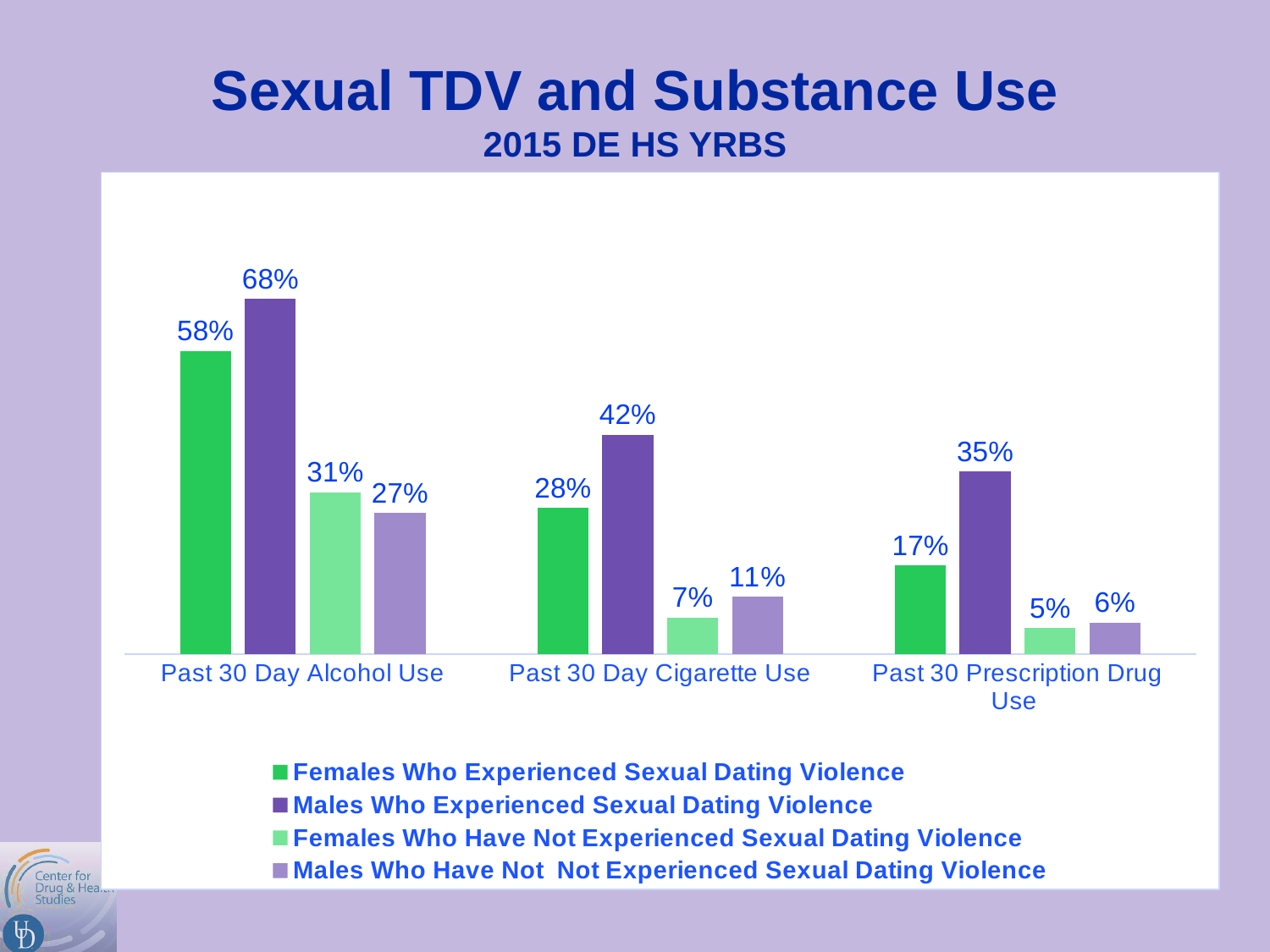
What is the value for Males Who Experienced Sexual Dating Violence for Past 30 Day Alcohol Use? 68% Do the values for Females Who Experienced Sexual Dating Violence rise or fall across the categories from left to right? Fall What is the difference between Males Who Experienced Sexual Dating Violence and Males Who Have Not Not Experienced Sexual Dating Violence for Past 30 Prescription Drug Use? 29% How many categories are shown on the x axis? 3 What kind of chart is shown on the slide? Bar chart What is the value for Females Who Experienced Sexual Dating Violence for Past 30 Prescription Drug Use? 17% For Past 30 Day Alcohol Use, which is larger: Females Who Have Not Experienced Sexual Dating Violence or Males Who Have Not Not Experienced Sexual Dating Violence? Females Who Have Not Experienced Sexual Dating Violence What is the difference between Males Who Experienced Sexual Dating Violence and Females Who Experienced Sexual Dating Violence for Past 30 Day Cigarette Use? 14% Which category has the highest value for Males Who Experienced Sexual Dating Violence? Past 30 Day Alcohol Use Which category has the lowest value for Females Who Have Not Experienced Sexual Dating Violence? Past 30 Prescription Drug Use How many series does the legend list? 4 What is the value for Females Who Have Not Experienced Sexual Dating Violence for Past 30 Day Cigarette Use? 7%